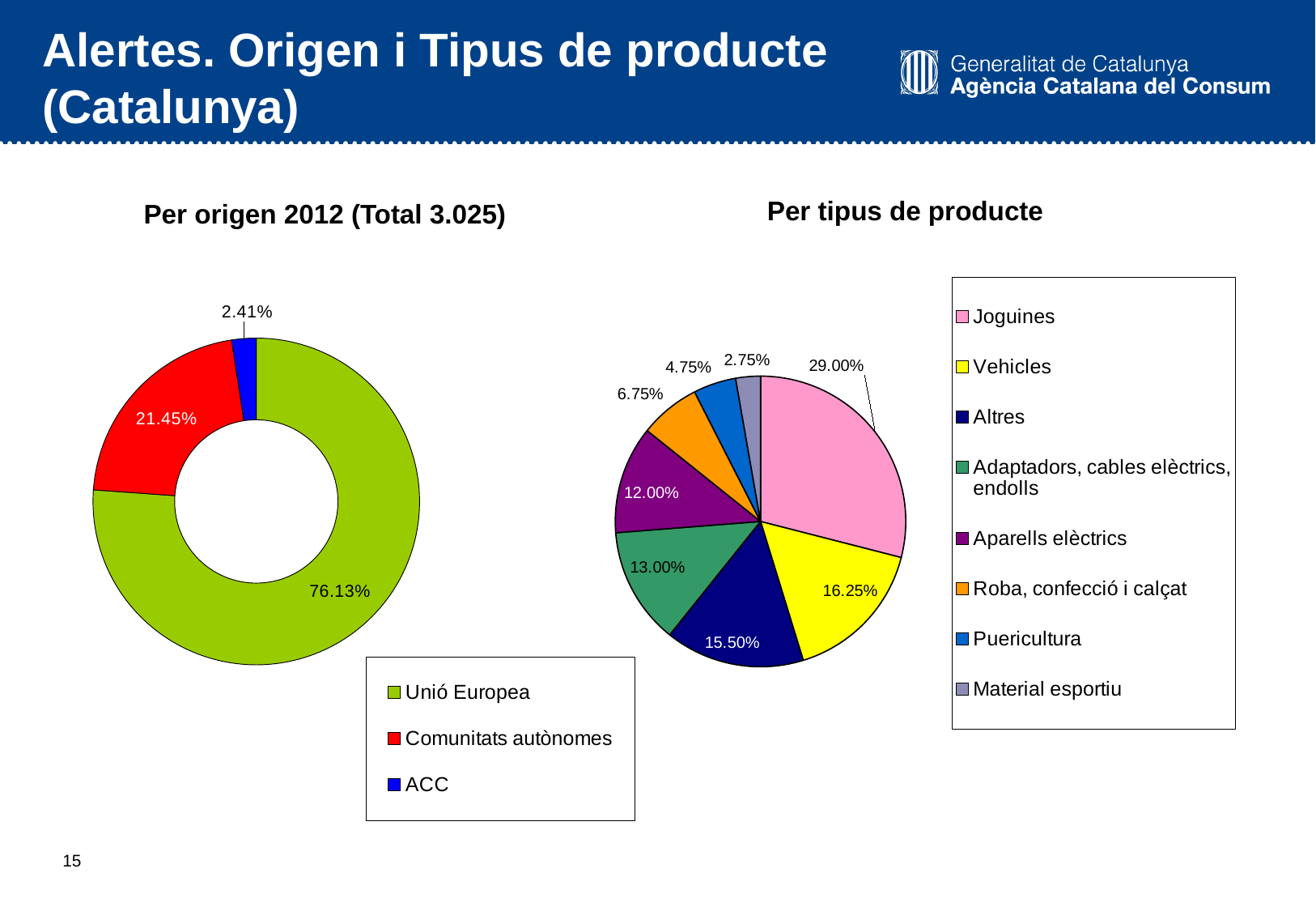
In the 'Per tipus de producte' chart, what share is labelled for Joguines? 29.00% In the 'Per tipus de producte' chart, what share is labelled for Aparells elèctrics? 12.00% In the 'Per tipus de producte' chart, what is the difference between the shares of Joguines and Vehicles? 12.75% In the 'Per tipus de producte' chart, which is larger: Altres or Adaptadors, cables elèctrics, endolls? Altres In the 'Per tipus de producte' chart, what share is labelled for Vehicles? 16.25% In the 'Per tipus de producte' chart, which category has the largest share? Joguines In the 'Per origen 2012 (Total 3.025)' chart, how many categories does the legend list? 3 What kind of chart is the 'Per origen 2012 (Total 3.025)' chart? Doughnut (pie) chart In the 'Per origen 2012 (Total 3.025)' chart, what share is labelled for Unió Europea? 76.13% In the 'Per origen 2012 (Total 3.025)' chart, which category has the smallest share? ACC In the 'Per origen 2012 (Total 3.025)' chart, what share is labelled for ACC? 2.41% In the 'Per origen 2012 (Total 3.025)' chart, what share is labelled for Comunitats autònomes? 21.45%